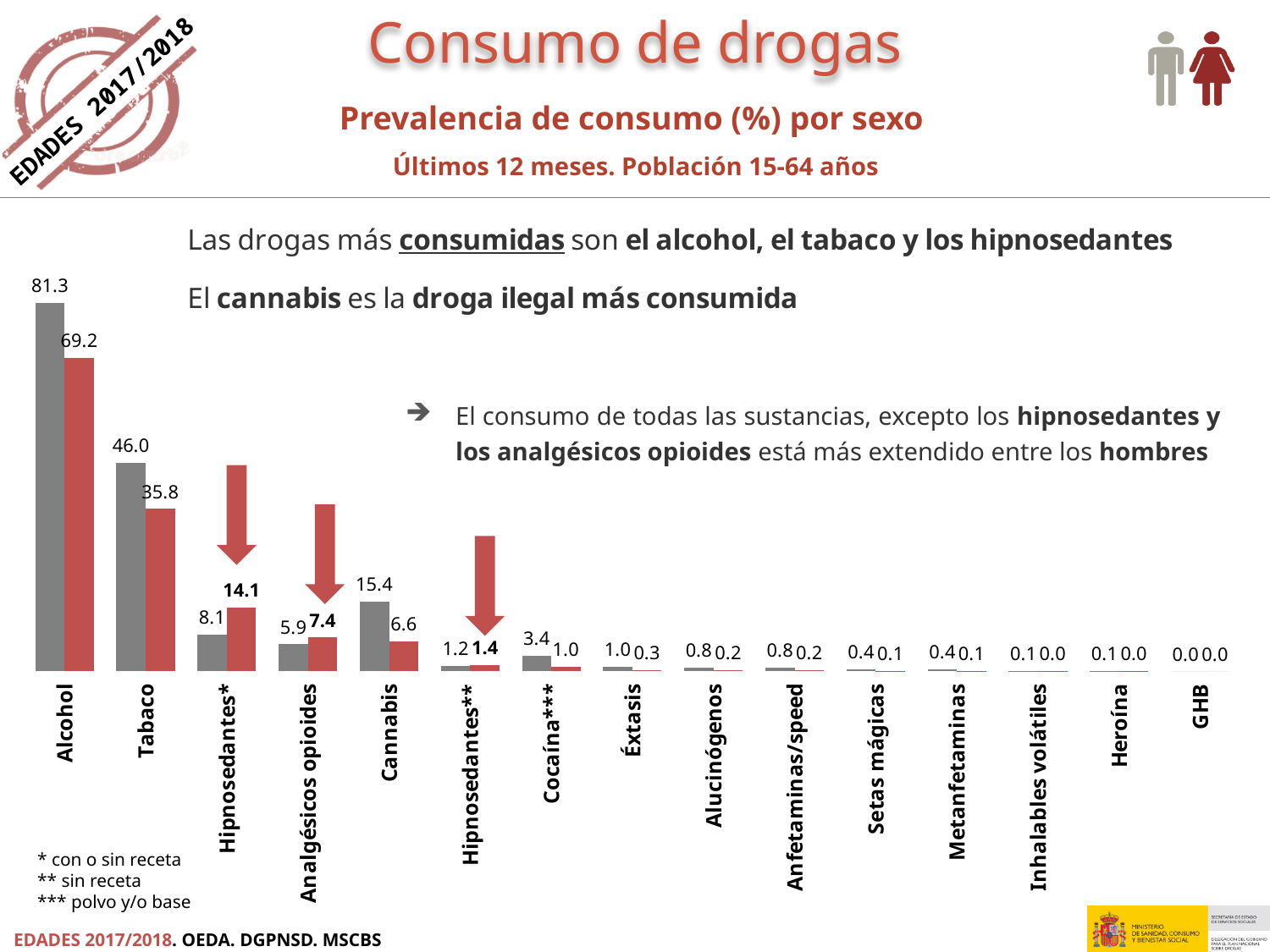
For Hipnosedantes*, which bar is larger, the grey or the red? red What is the difference between the red and grey bars for Analgésicos opioides? 1.5 How many categories are shown on the x axis of the chart? 15 Which category has the lowest red bar value among Cannabis, Cocaína*** and Éxtasis? Éxtasis What kind of chart is shown on the slide? bar chart What is the value of the red bar for Hipnosedantes*? 14.1 What is the value of the red bar for Tabaco? 35.8 What is the difference between the grey and red bars for Alcohol? 12.1 What is the value of the grey bar for Cannabis? 15.4 What is the value of the grey bar for Alcohol? 81.3 Which category has the highest grey bar? Alcohol For Cocaína***, which bar is larger, the grey or the red? grey